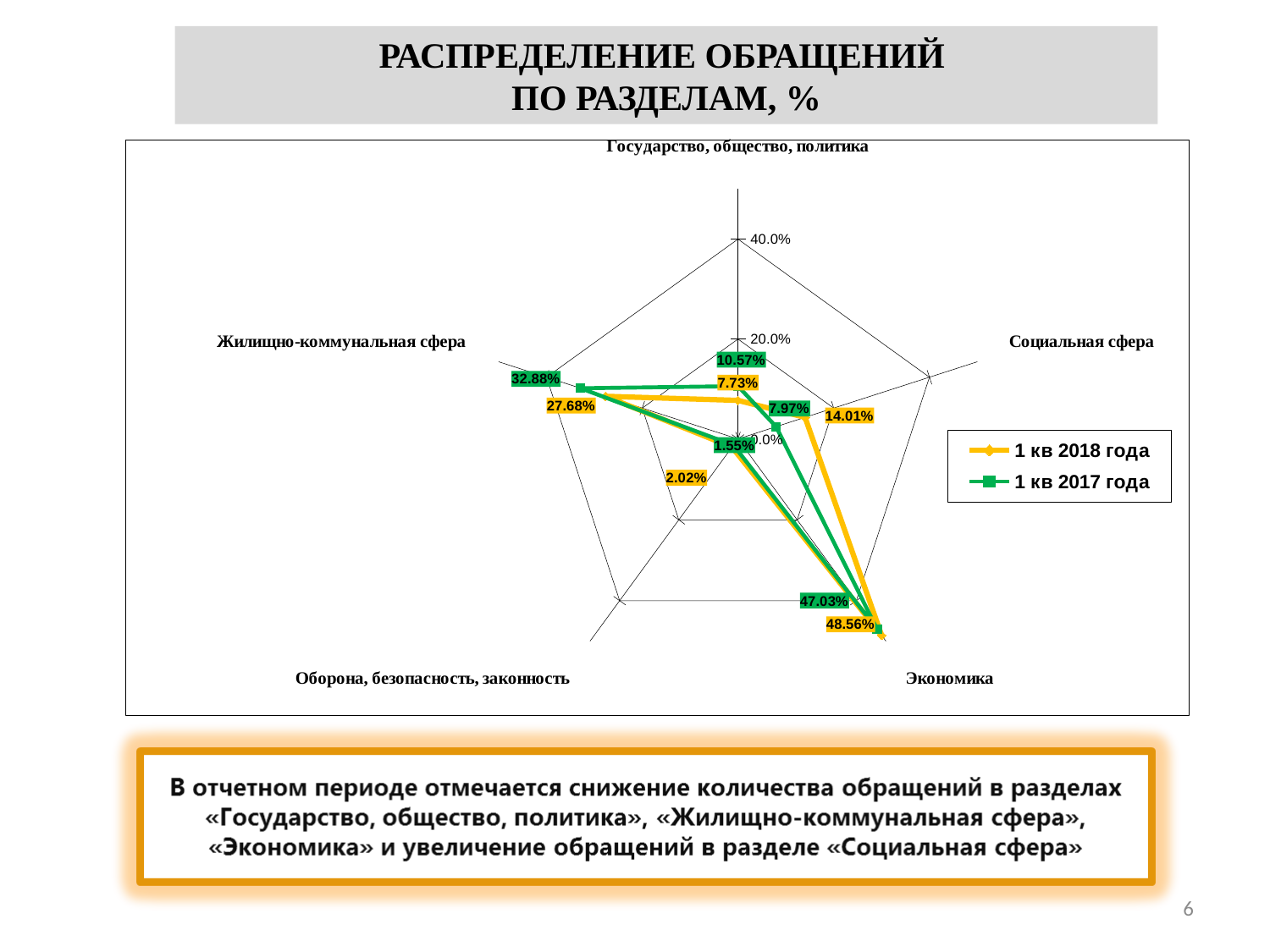
What is the value for Социальная сфера in the 1 кв 2018 года series? 14.01% For Жилищно-коммунальная сфера, which series has the larger value: 1 кв 2018 года or 1 кв 2017 года? 1 кв 2017 года What is the value for Государство, общество, политика in the 1 кв 2017 года series? 10.57% What is the value for Экономика in the 1 кв 2018 года series? 48.56% What kind of chart is shown on the slide? Radar chart What is the title of the chart on the slide? РАСПРЕДЕЛЕНИЕ ОБРАЩЕНИЙ ПО РАЗДЕЛАМ, % How many series does the legend list? 2 Which category has the highest value in the 1 кв 2018 года series? Экономика What is the value for Жилищно-коммунальная сфера in the 1 кв 2017 года series? 32.88% Which category has the lowest value in the 1 кв 2017 года series? Оборона, безопасность, законность What is the difference between the 1 кв 2018 года and 1 кв 2017 года values for Социальная сфера? 6.04% How many categories (axes) does the radar chart have? 5